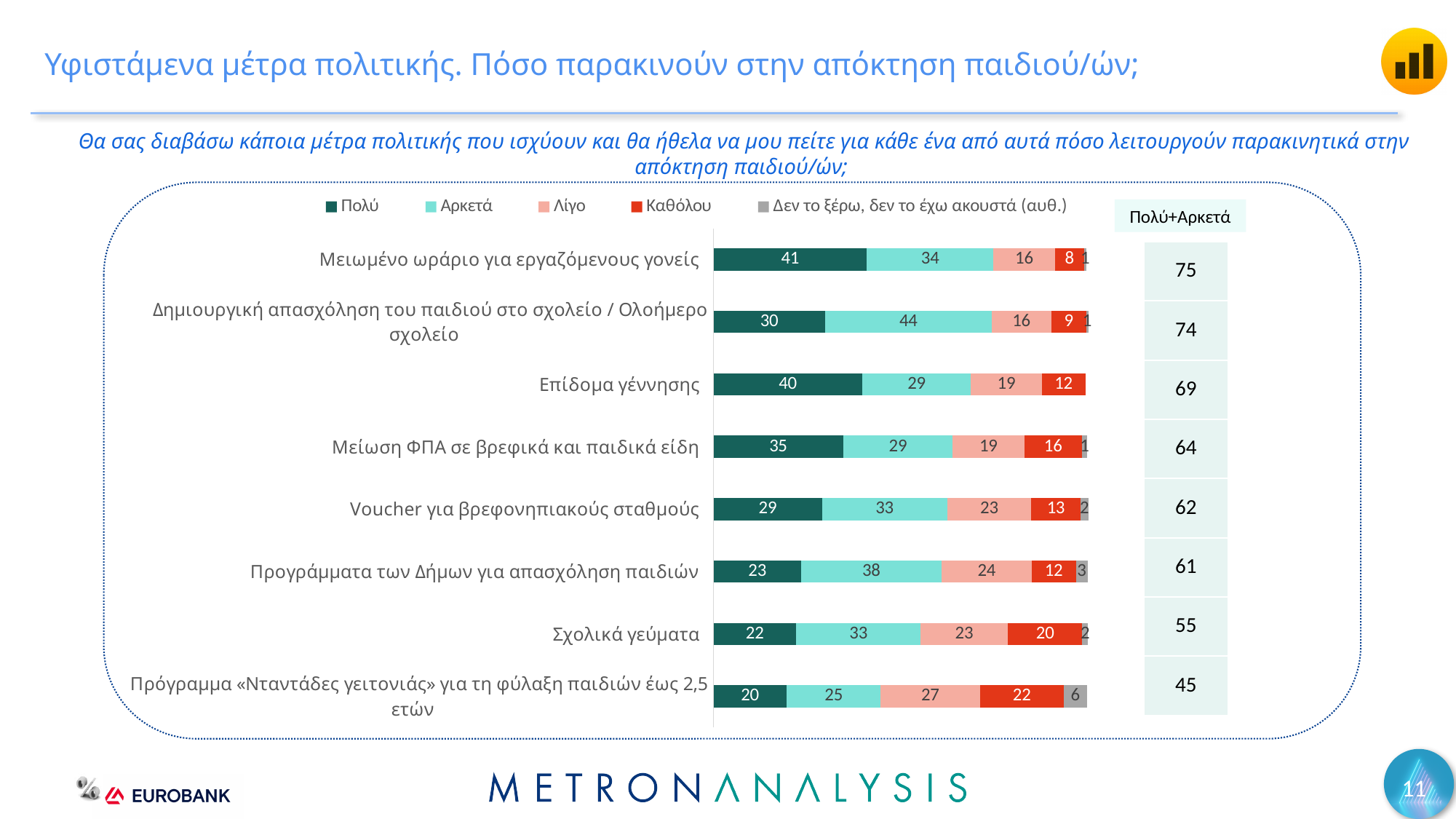
What percentage of respondents answered "Πολύ" for "Μειωμένο ωράριο για εργαζόμενους γονείς"? 41 How many series does the legend list? 5 What is the difference between the "Πολύ" values for "Επίδομα γέννησης" and "Σχολικά γεύματα"? 18 Which legend entry is shown in grey? Δεν το ξέρω, δεν το έχω ακουστά (αυθ.) What is the "Αρκετά" value for "Δημιουργική απασχόληση του παιδιού στο σχολείο / Ολοήμερο σχολείο"? 44 Which has a larger "Καθόλου" value: "Μείωση ΦΠΑ σε βρεφικά και παιδικά είδη" or "Voucher για βρεφονηπιακούς σταθμούς"? Μείωση ΦΠΑ σε βρεφικά και παιδικά είδη Which measure has the highest "Πολύ+Αρκετά" total? Μειωμένο ωράριο για εργαζόμενους γονείς Which measure has the lowest "Πολύ+Αρκετά" total? Πρόγραμμα «Νταντάδες γειτονιάς» για τη φύλαξη παιδιών έως 2,5 ετών What is the "Καθόλου" value for "Σχολικά γεύματα"? 20 How many policy measures (categories) are shown in the chart? 8 What kind of chart is shown on the slide? Stacked bar chart What is the "Πολύ+Αρκετά" total for "Προγράμματα των Δήμων για απασχόληση παιδιών"? 61